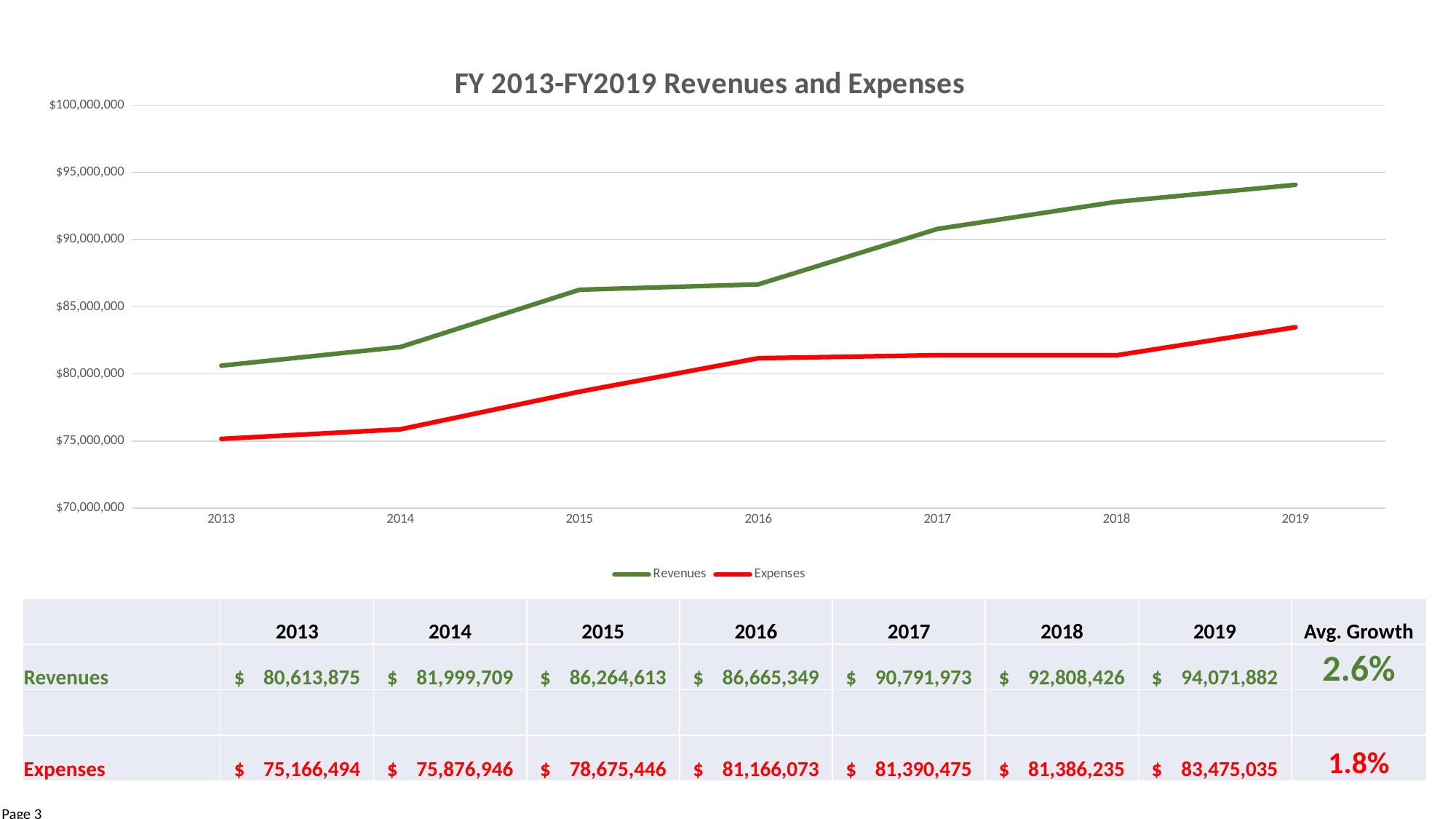
Do Revenues rise or fall from 2013 to 2019? Rise What is the Expenses value for 2013? $75,166,494 What is the Revenues value for 2019? $94,071,882 How many series does the legend list? 2 What is the Revenues value for 2016? $86,665,349 What is the difference between Revenues and Expenses in 2019? $10,596,847 What is the title of the chart? FY 2013-FY2019 Revenues and Expenses What type of chart is shown on the slide? Line chart In which year are Expenses lowest? 2013 How many years are plotted along the x axis? 7 Which is larger in 2017, Revenues or Expenses? Revenues In which year are Revenues highest? 2019